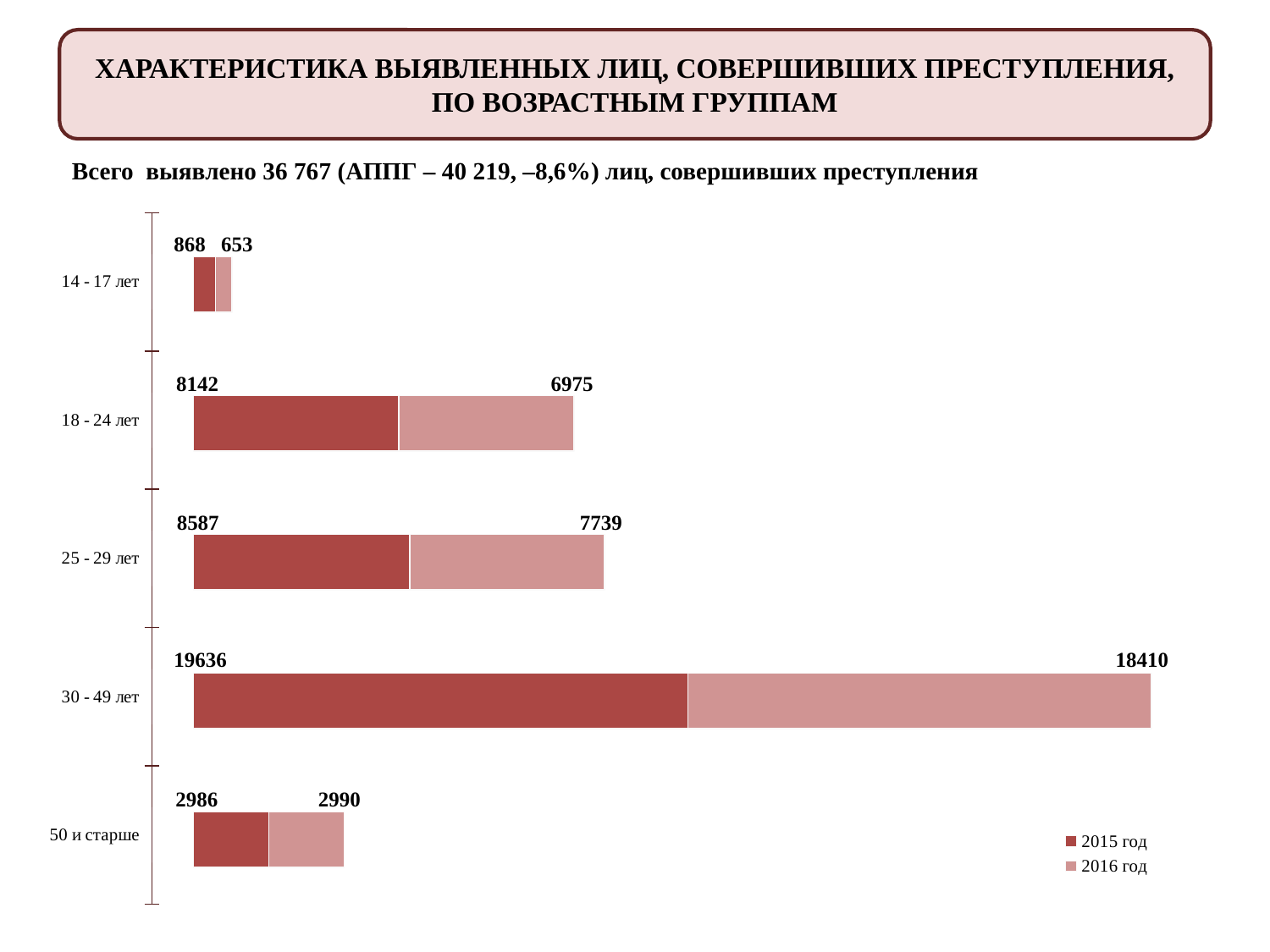
How many series does the legend list? 2 Which age group has the lowest value for 2016 год? 14 - 17 лет How many age group categories are shown on the chart? 5 Which is larger for the 50 и старше category: the 2015 год value or the 2016 год value? 2016 год What kind of chart is shown on the slide? Stacked bar chart Which series is shown in the darker red colour? 2015 год What is the total of the stacked bar for the 18 - 24 лет category? 15117 What is the value for the 2016 год series in the 14 - 17 лет category? 653 What is the value for the 2015 год series in the 30 - 49 лет category? 19636 What is the difference between the 2015 год and 2016 год values for the 25 - 29 лет category? 848 Which age group has the highest value for 2015 год? 30 - 49 лет What is the value for the 2016 год series in the 18 - 24 лет category? 6975